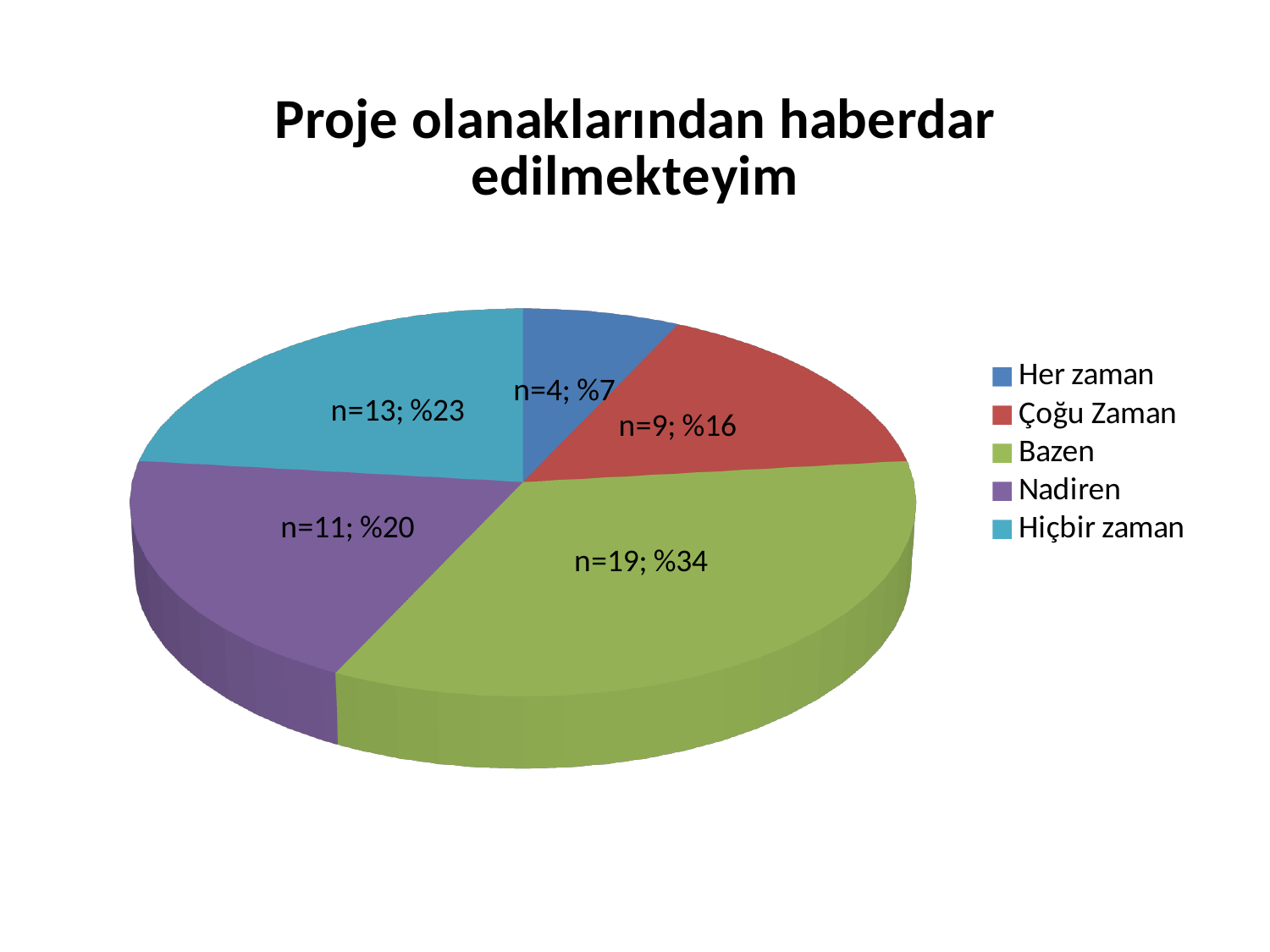
What is the count (n) for Her zaman? n=4 What kind of chart is shown on the slide? pie chart What is the difference in count between Bazen and Çoğu Zaman? 10 How many slices does the pie chart have? 5 Which is larger, Nadiren or Hiçbir zaman? Hiçbir zaman Which category has the largest slice? Bazen What is the count (n) for Bazen? n=19 What percentage share does Nadiren have? %20 Which category has the smallest slice? Her zaman What percentage share does Hiçbir zaman have? %23 What is the total count across all slices? 56 What is the title of the chart? Proje olanaklarından haberdar edilmekteyim